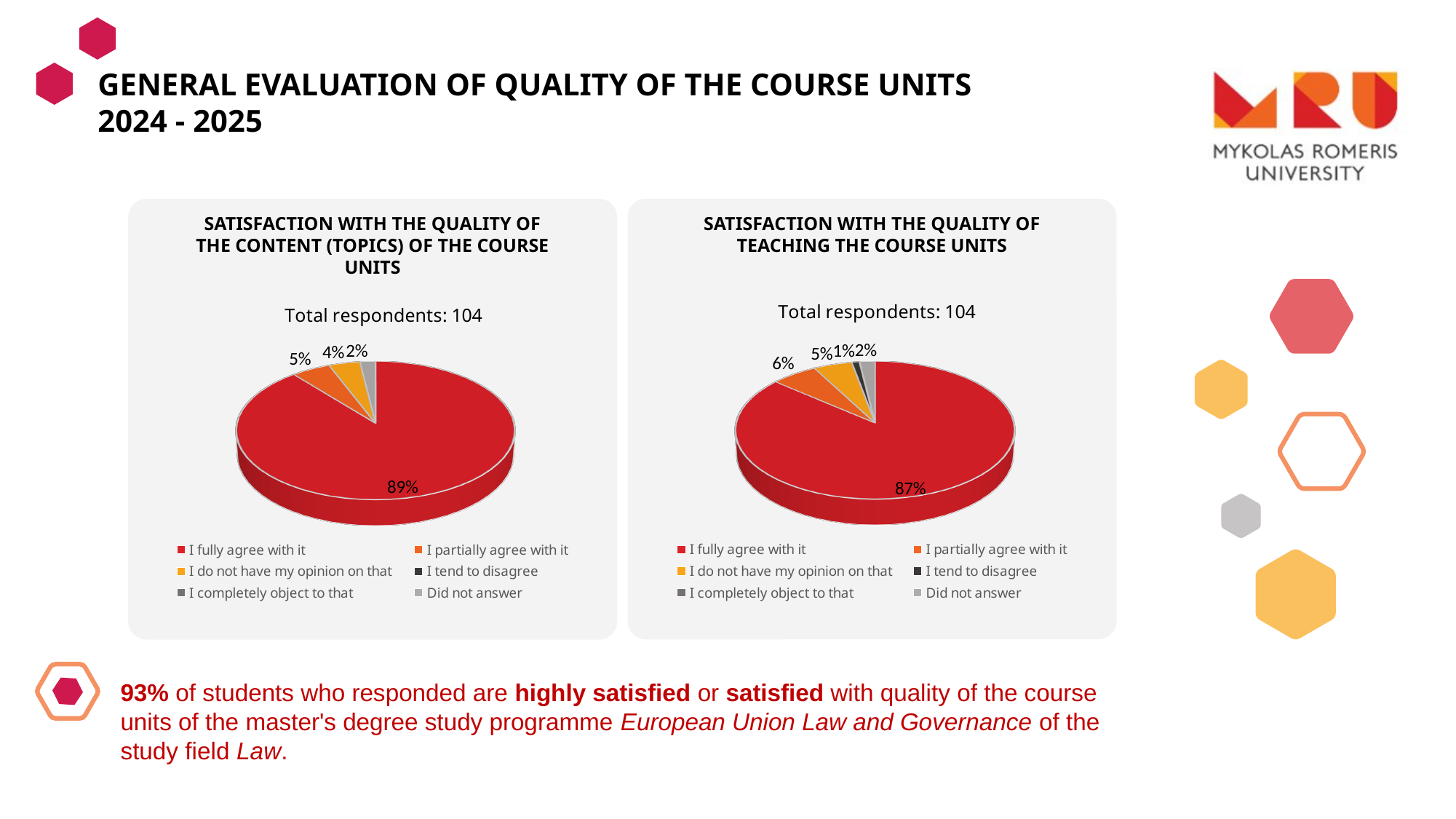
In the right chart (teaching the course units), what percentage is shown for 'I partially agree with it'? 6% What type of chart is used in the 'Satisfaction with the quality of teaching the course units' panel? Pie chart In the right chart (teaching the course units), what percentage is shown for 'I tend to disagree'? 1% In the chart titled 'Satisfaction with the quality of the content (topics) of the course units', what share of respondents chose 'I fully agree with it'? 89% How many entries does the legend of the left chart (content of the course units) list? 6 In the chart titled 'Satisfaction with the quality of teaching the course units', what share of respondents chose 'I fully agree with it'? 87% In the left chart (content of the course units), which response has the largest share? I fully agree with it In the right chart (teaching the course units), which labelled response has the smallest share? I tend to disagree In the left chart (content of the course units), what percentage is shown for 'I partially agree with it'? 5% How many total respondents are reported for the 'Satisfaction with the quality of the content (topics) of the course units' chart? 104 Which chart shows a larger share for 'I do not have my opinion on that': the content chart or the teaching chart? The teaching chart What is the difference between the 'I fully agree with it' share in the left chart (content) and in the right chart (teaching)? 2%